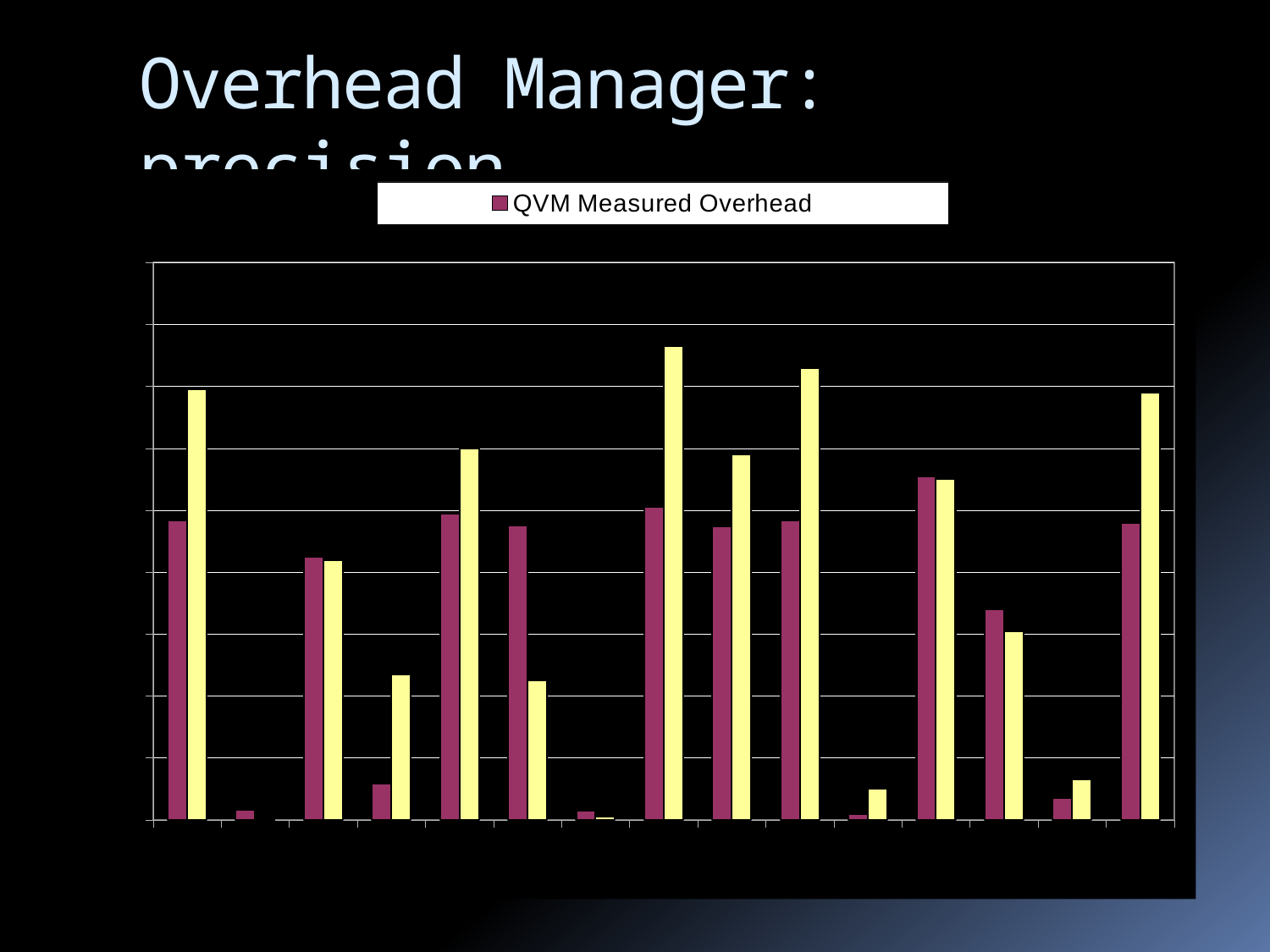
What is the legend entry shown above the chart? QVM Measured Overhead How many category groups of bars are plotted along the x axis? 15 What colour are the bars for the QVM Measured Overhead series? purple Is the tallest bar in the chart a purple bar or a yellow bar? yellow What kind of chart is shown on the slide? bar chart